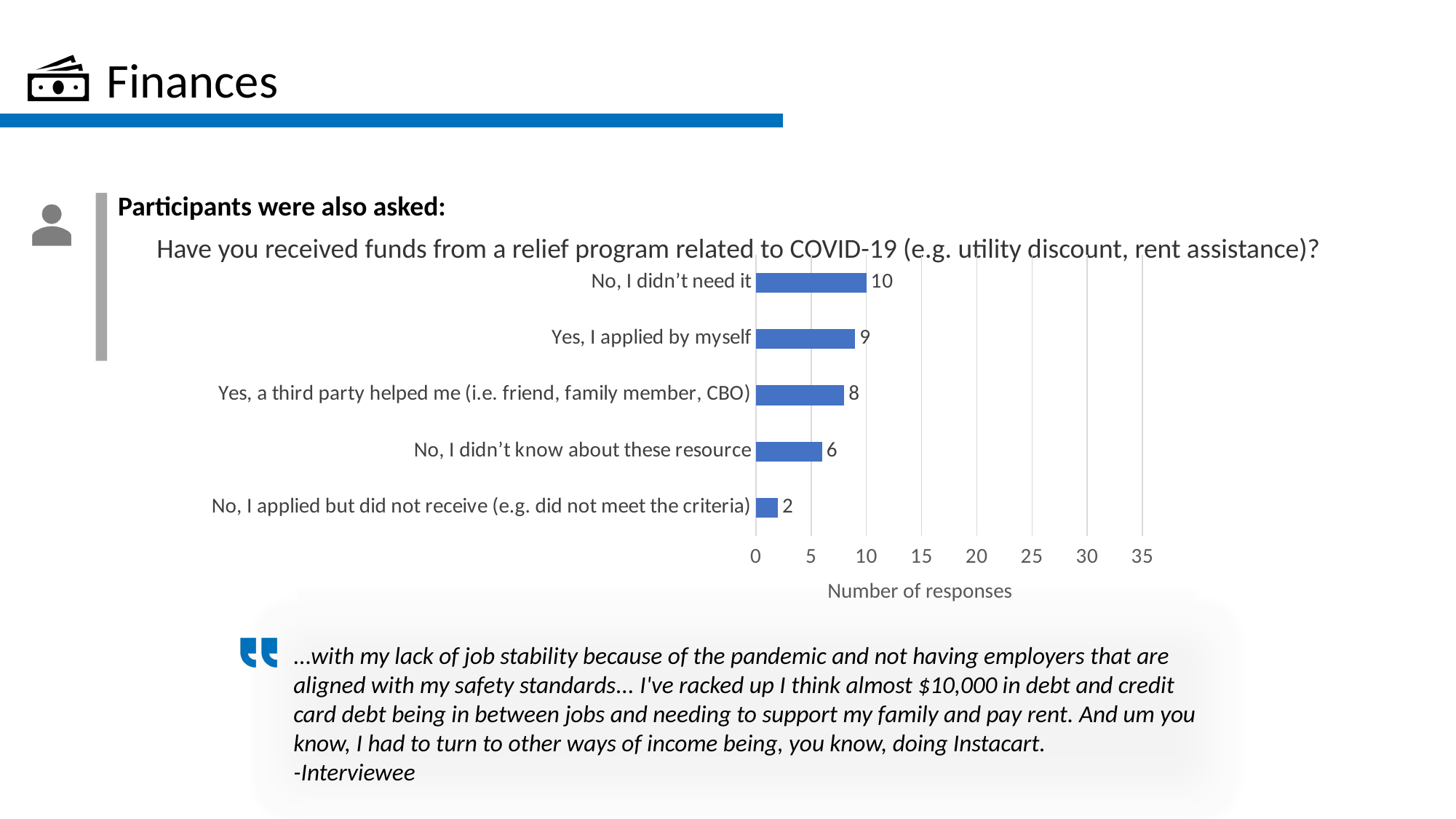
How many responses were recorded for "No, I didn't need it"? 10 How many responses were recorded for "Yes, I applied by myself"? 9 What is the label of the horizontal axis of the chart? Number of responses How many responses were recorded for "Yes, a third party helped me (i.e. friend, family member, CBO)"? 8 How many responses were recorded for "No, I didn't know about these resource"? 6 Which received more responses: "Yes, I applied by myself" or "No, I didn't know about these resource"? Yes, I applied by myself How many response categories are shown in the chart? 5 Which response category received the fewest responses? No, I applied but did not receive (e.g. did not meet the criteria) Which response category received the most responses? No, I didn't need it What type of chart is used to show the responses? Bar chart What is the difference in responses between "No, I didn't need it" and "No, I applied but did not receive (e.g. did not meet the criteria)"? 8 How many responses were recorded for "No, I applied but did not receive (e.g. did not meet the criteria)"? 2